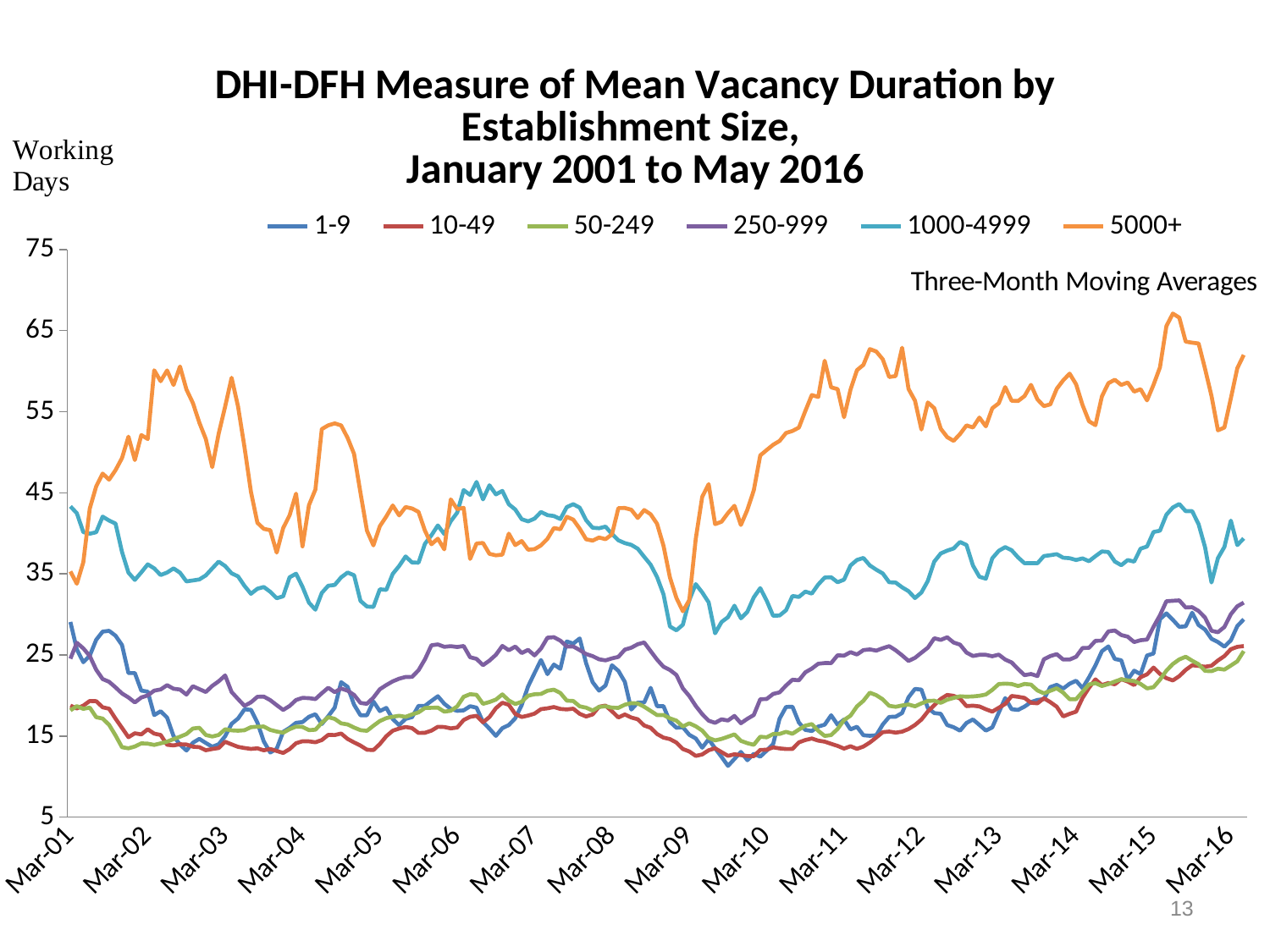
What is the label on the vertical axis of the chart? Working Days Is the value for the 1-9 series at Mar-01 greater or less than 25? greater At Mar-16, which is larger: the 250-999 series or the 50-249 series? 250-999 Which establishment size series has the highest vacancy duration across most of the period? 5000+ Is the peak value of the 5000+ series greater or less than 65? greater Which establishment size series is the second highest across most of the period? 1000-4999 How many series does the legend list? 6 What note appears in the upper right of the plot area describing how the data are smoothed? Three-Month Moving Averages What type of chart is shown on the slide? line chart Is the value for the 250-999 series at Mar-16 greater or less than 25? greater Does the 5000+ series rise or fall between Mar-09 and Mar-11? rise